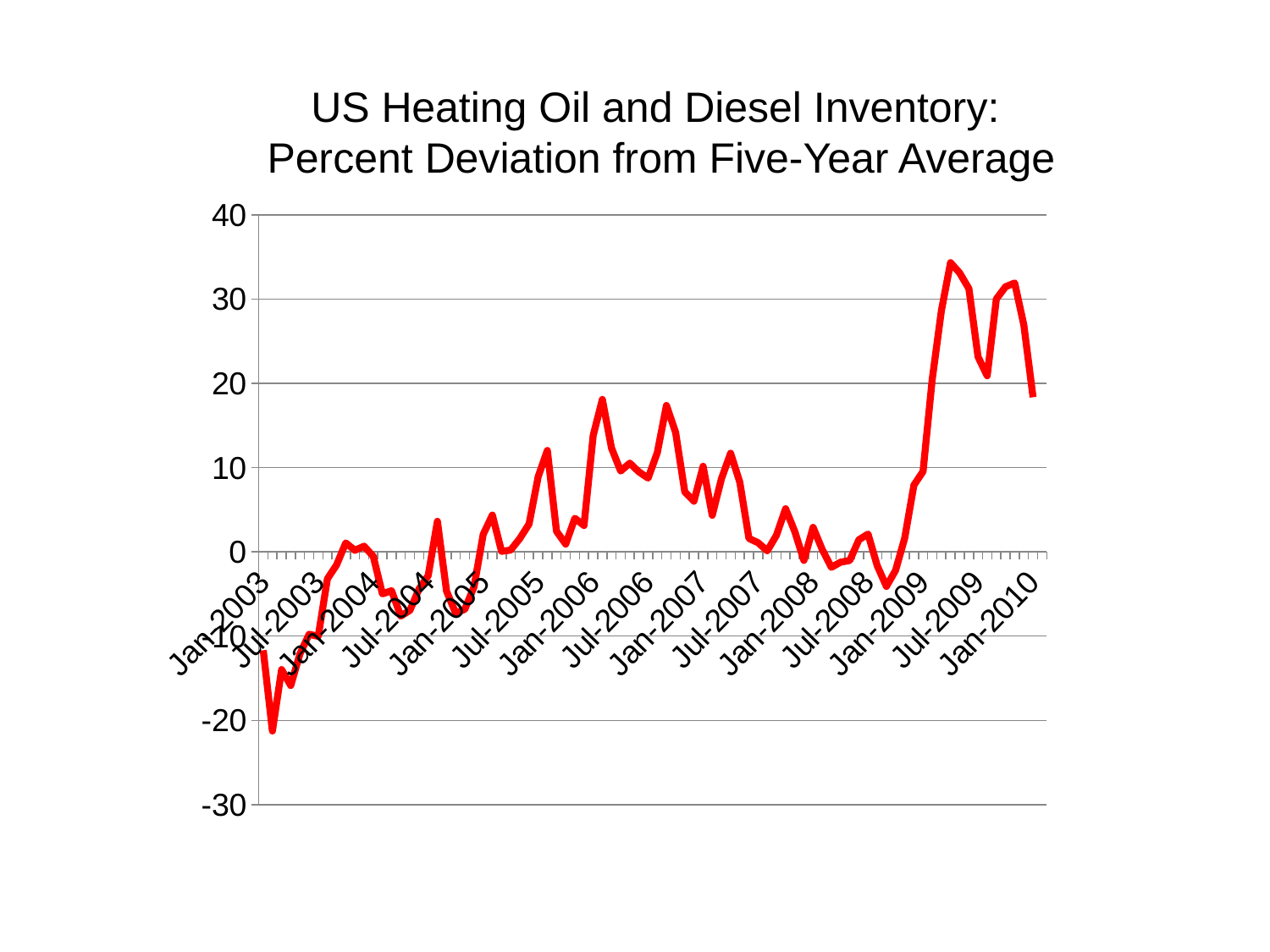
How many date labels are shown along the x axis? 15 Which is larger, the value around Jul-2009 or the value at Jan-2003? Jul-2009 Is the value at Jul-2006 greater or less than 0? greater What is the highest value shown on the y axis? 40 In which period does the line reach its highest point? between Jan-2009 and Jul-2009 What is the title of the chart? US Heating Oil and Diesel Inventory: Percent Deviation from Five-Year Average Is the value at Jan-2003 greater or less than -10? less Overall, does the line rise or fall from Jan-2003 to Jan-2010? rise Is the value at Jan-2008 greater or less than 10? less What kind of chart is shown on the slide? line chart